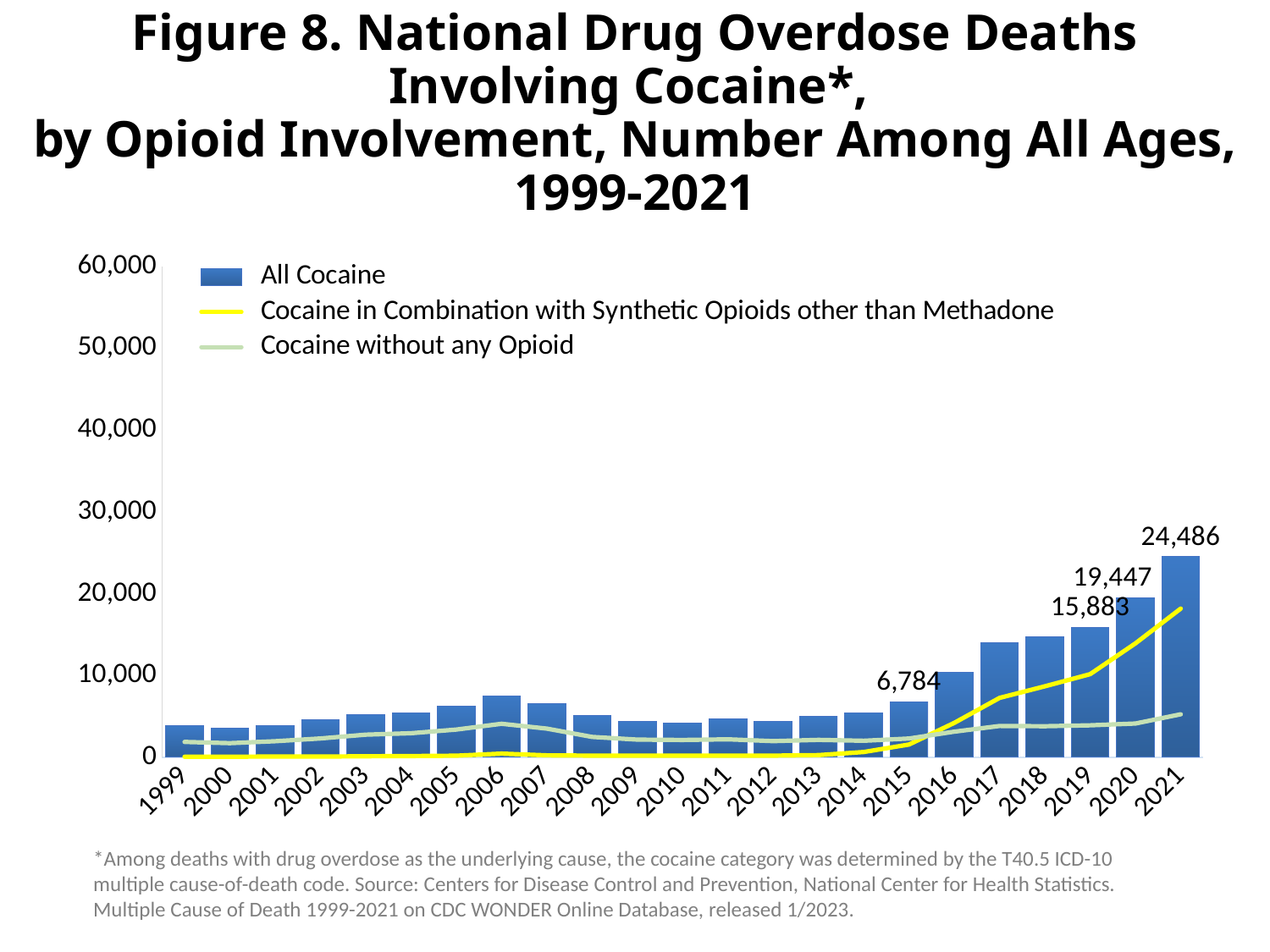
How many years are shown on the x axis? 23 How many series does the legend list? 3 Is the All Cocaine value for 2017 greater or less than 10,000? greater Which year has more All Cocaine overdose deaths, 2018 or 2020? 2020 What is the number of All Cocaine overdose deaths in 2020? 19,447 What is the difference in All Cocaine overdose deaths between 2021 and 2020? 5,039 Is the value for Cocaine in Combination with Synthetic Opioids other than Methadone in 2021 greater or less than 20,000? less Do the All Cocaine values rise or fall from 2015 to 2021? rise Which year has the highest number of All Cocaine overdose deaths? 2021 What is the number of All Cocaine overdose deaths in 2021? 24,486 What is the number of All Cocaine overdose deaths in 2015? 6,784